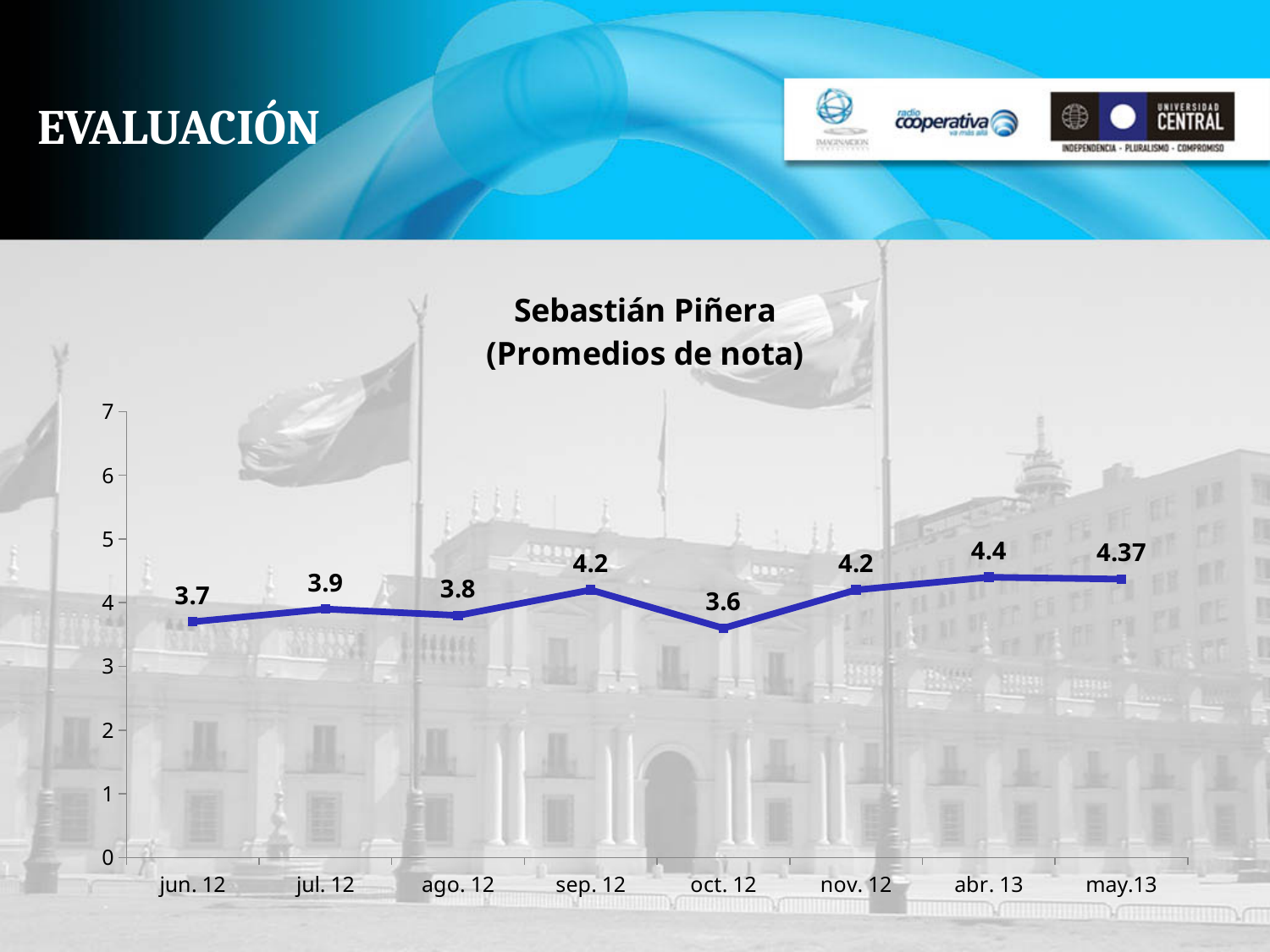
Is the value for sep. 12 greater or less than 4? greater What is the value for abr. 13? 4.4 Which is larger, the value for jul. 12 or the value for ago. 12? jul. 12 What is the title of the chart? Sebastián Piñera (Promedios de nota) What is the difference between the values for abr. 13 and jun. 12? 0.7 Which month has the lowest value? oct. 12 How many data points are plotted on the chart? 8 What is the value for may.13? 4.37 What is the value for oct. 12? 3.6 What kind of chart is shown? line chart What is the value for jun. 12? 3.7 Which month has the highest value? abr. 13